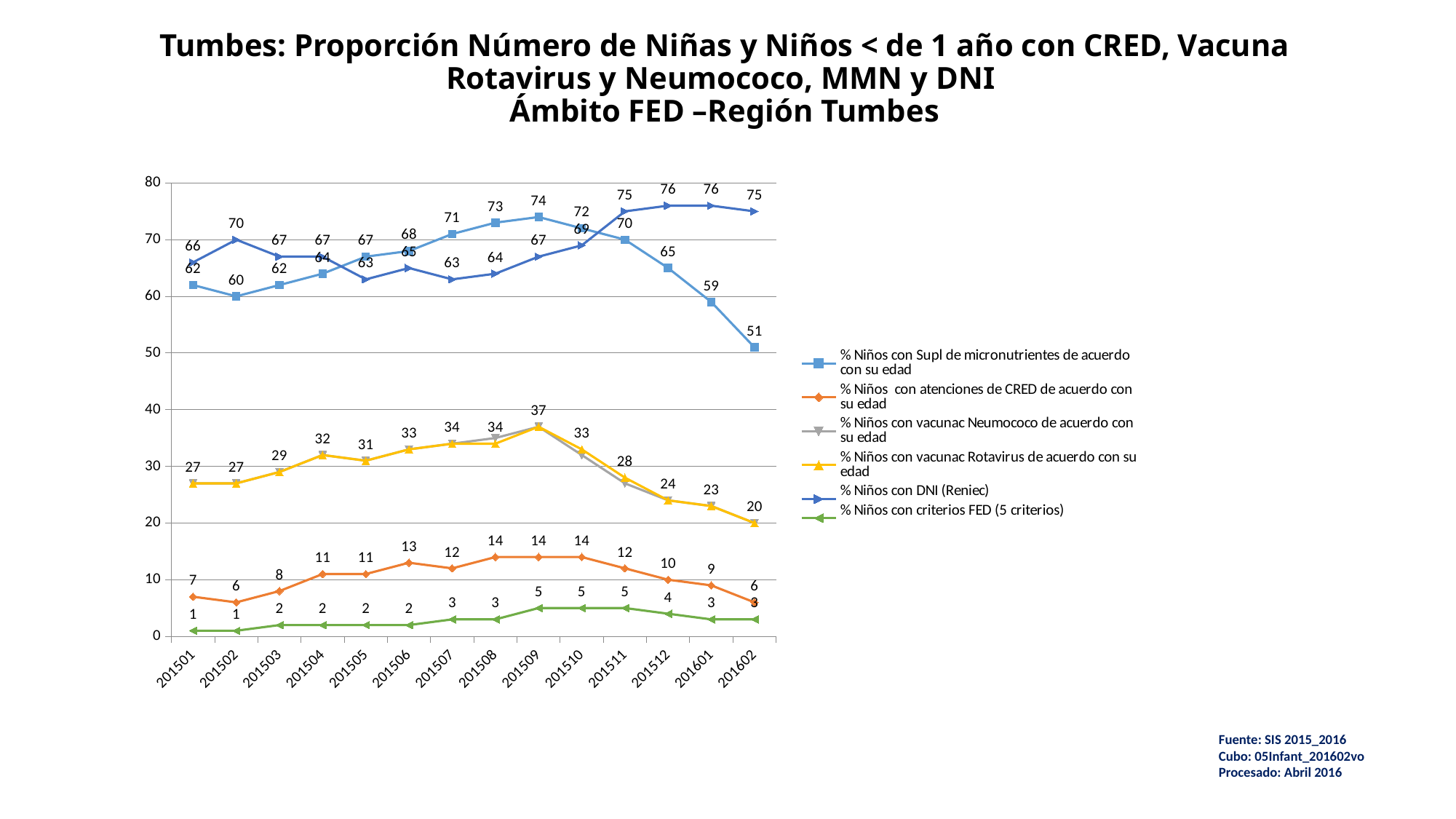
What is the difference between the % Niños con DNI (Reniec) value at 201602 and at 201501? 9 How many periods are shown on the x axis? 14 What is the value of % Niños con criterios FED (5 criterios) at 201509? 5 How many series does the legend list? 6 What is the value of % Niños con atenciones de CRED de acuerdo con su edad at 201508? 14 What kind of chart is shown on the slide? Line chart In which period does % Niños con Supl de micronutrientes de acuerdo con su edad reach its highest value? 201509 What is the difference between the % Niños con Supl de micronutrientes value at 201509 and at 201602? 23 At 201501, which is larger: % Niños con DNI (Reniec) or % Niños con Supl de micronutrientes de acuerdo con su edad? % Niños con DNI (Reniec) What is the value of % Niños con DNI (Reniec) at 201512? 76 In which period does % Niños con Supl de micronutrientes de acuerdo con su edad reach its lowest value? 201602 What is the value of % Niños con Supl de micronutrientes de acuerdo con su edad at 201602? 51